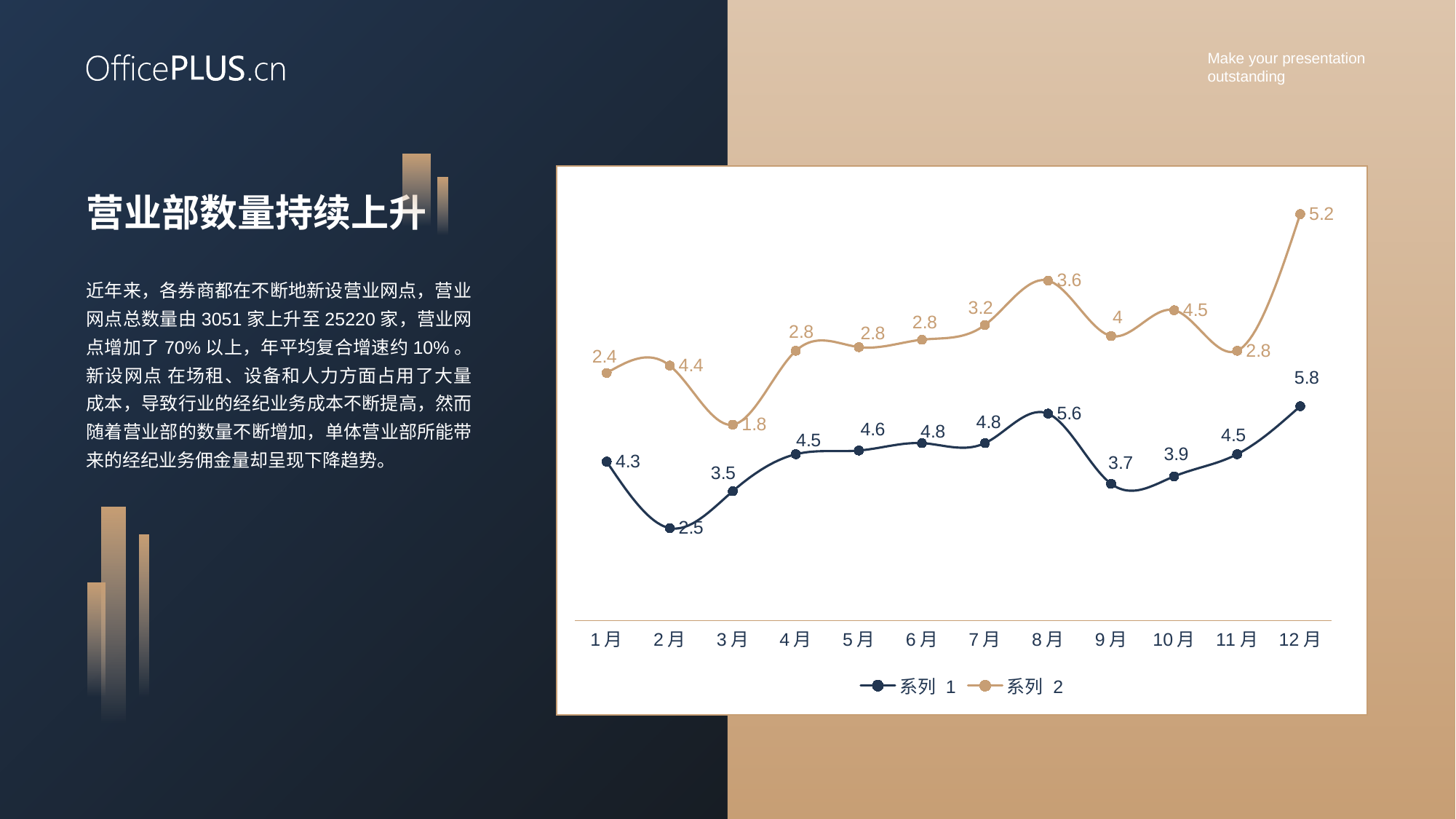
For 系列 1, which is larger: the value in 1月 or the value in 3月? 1月 How many months are shown on the x axis? 12 What is the value of 系列 2 in 12月? 5.2 What kind of chart is shown on the slide? line chart What is the value of 系列 1 in 8月? 5.6 In which month does 系列 2 have its lowest value? 3月 What is the difference between the 系列 1 values in 12月 and 2月? 3.3 How many series does the legend list? 2 What is the value of 系列 2 in 9月? 4 What is the value of 系列 1 in 1月? 4.3 In which month does 系列 1 reach its highest value? 12月 In which month does 系列 1 have its lowest value? 2月